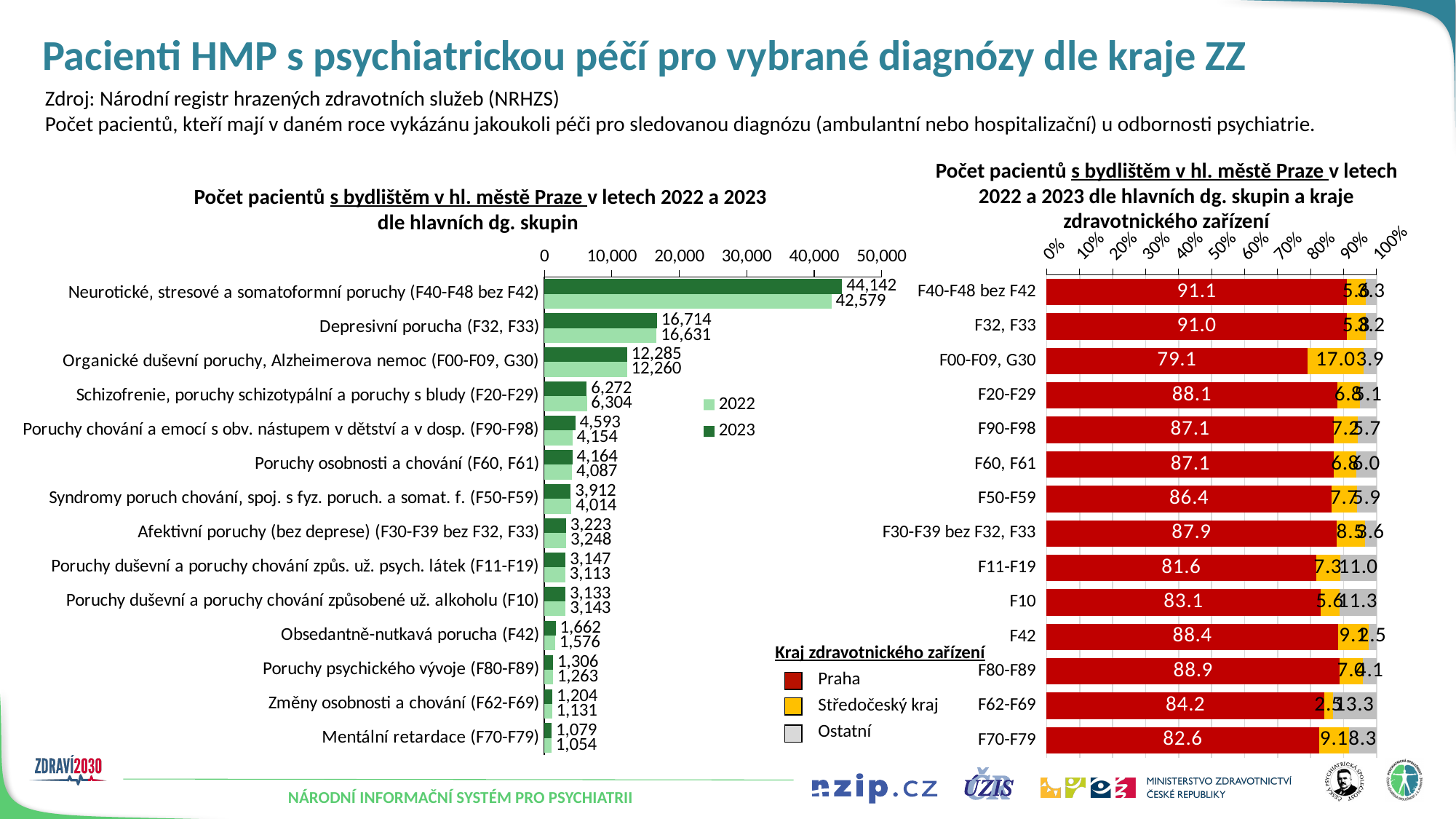
In the right chart, what is the Středočeský kraj percentage for F00-F09, G30? 17.0 In the right chart, which diagnosis group has the lowest Praha share? F00-F09, G30 In the left chart, what is the 2022 value for Depresivní porucha (F32, F33)? 16,631 In the left chart, what is the difference between the 2023 and 2022 values for Neurotické, stresové a somatoformní poruchy (F40-F48 bez F42)? 1,563 In the left chart, which diagnosis group has the lowest 2022 value? Mentální retardace (F70-F79) In the left chart (Počet pacientů s bydlištěm v hl. městě Praze v letech 2022 a 2023 dle hlavních dg. skupin), what is the 2023 value for Neurotické, stresové a somatoformní poruchy (F40-F48 bez F42)? 44,142 How many diagnosis groups are shown in the left chart? 14 In the right chart, what is the Praha percentage for F00-F09, G30? 79.1 In the left chart, for Schizofrenie, poruchy schizotypální a poruchy s bludy (F20-F29), which year has the larger value, 2022 or 2023? 2022 In the left chart, which diagnosis group has the highest 2023 value? Neurotické, stresové a somatoformní poruchy (F40-F48 bez F42) How many series does the legend of the left chart list? 2 What kind of chart is the right chart (Počet pacientů ... dle hlavních dg. skupin a kraje zdravotnického zařízení)? Stacked bar chart